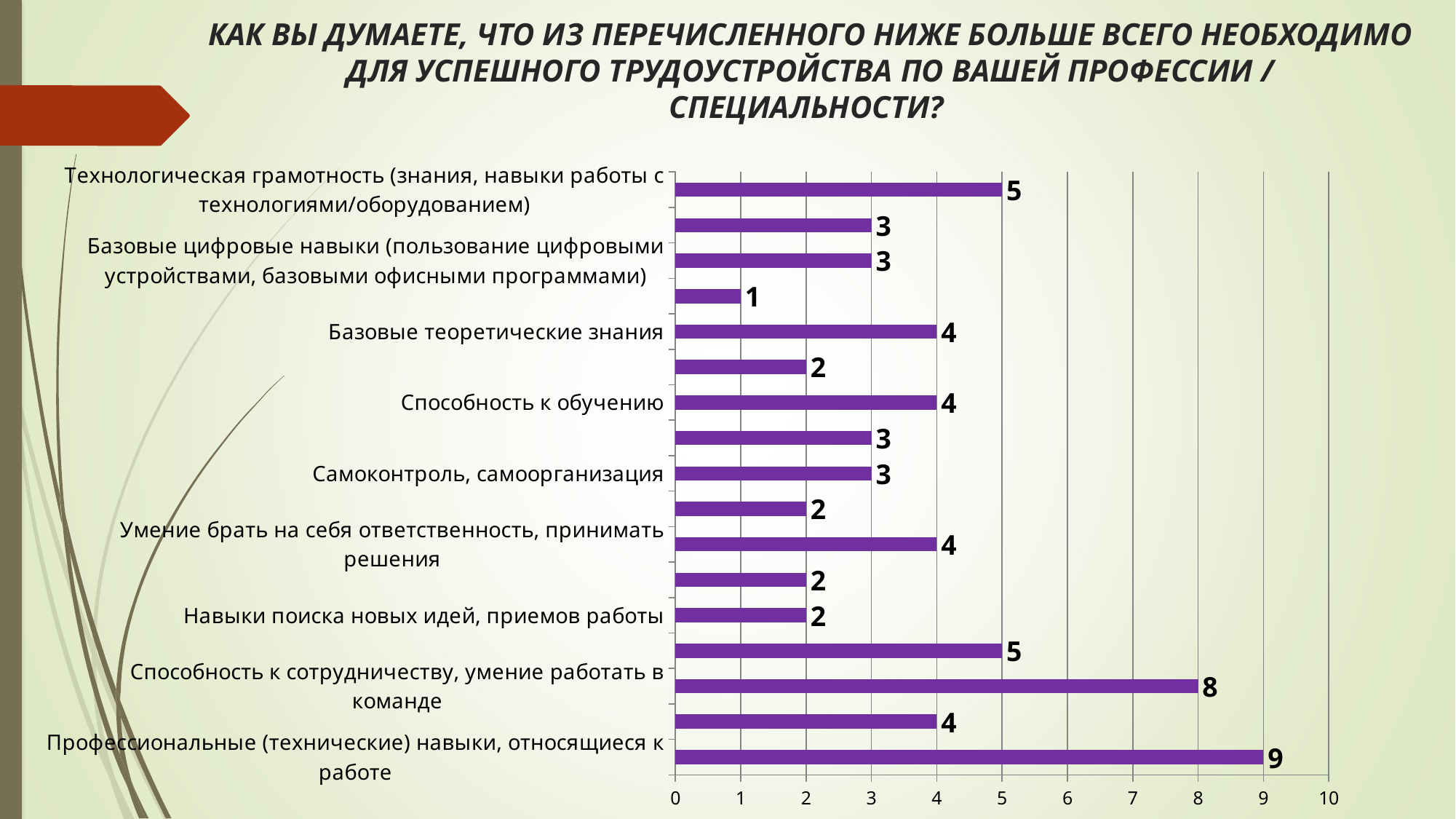
Which labeled category has the highest value? Профессиональные (технические) навыки, относящиеся к работе What kind of chart is shown on the slide? bar chart What value is shown for «Самоконтроль, самоорганизация»? 3 What is the difference between the values for «Профессиональные (технические) навыки, относящиеся к работе» and «Способность к сотрудничеству, умение работать в команде»? 1 What value is shown for «Способность к сотрудничеству, умение работать в команде»? 8 What is the smallest value shown on any bar in the chart? 1 What value is shown for «Навыки поиска новых идей, приемов работы»? 2 Is the value for «Способность к сотрудничеству, умение работать в команде» greater or less than 6? greater What value is shown for «Профессиональные (технические) навыки, относящиеся к работе»? 9 What is the maximum value shown on the horizontal axis? 10 Which is larger: the value for «Базовые теоретические знания» or the value for «Базовые цифровые навыки»? Базовые теоретические знания What value is shown for «Технологическая грамотность (знания, навыки работы с технологиями/оборудованием)»? 5